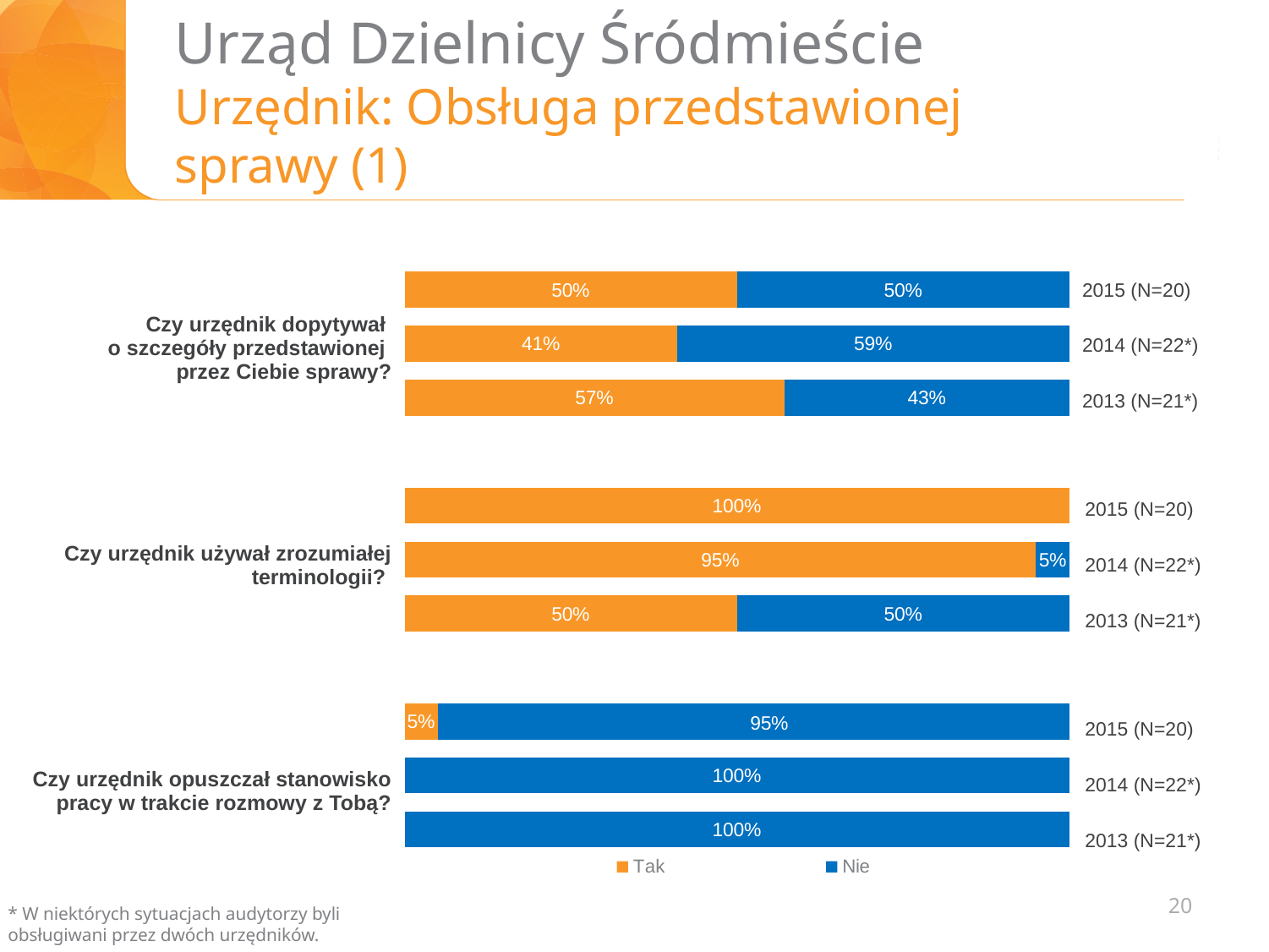
How many series does the legend list? 2 For the question "Czy urzędnik używał zrozumiałej terminologii?", is the "Tak" value for 2014 (N=22*) larger or smaller than the "Tak" value for 2013 (N=21*)? Larger What kind of chart is shown on the slide? Stacked bar chart For the question "Czy urzędnik dopytywał o szczegóły przedstawionej przez Ciebie sprawy?", what is the "Tak" value for 2014 (N=22*)? 41% For the question "Czy urzędnik używał zrozumiałej terminologii?", what is the "Tak" value for 2015 (N=20)? 100% For the question "Czy urzędnik dopytywał o szczegóły przedstawionej przez Ciebie sprawy?", what is the difference between the "Nie" value for 2014 (N=22*) and the "Nie" value for 2013 (N=21*)? 16% For the question "Czy urzędnik dopytywał o szczegóły przedstawionej przez Ciebie sprawy?", what is the "Nie" value for 2013 (N=21*)? 43% For the question "Czy urzędnik dopytywał o szczegóły przedstawionej przez Ciebie sprawy?", which year has the highest "Tak" value? 2013 (N=21*) For the question "Czy urzędnik opuszczał stanowisko pracy w trakcie rozmowy z Tobą?", what is the "Nie" value for 2015 (N=20)? 95% What are the two series named in the legend? Tak and Nie For the question "Czy urzędnik używał zrozumiałej terminologii?", which year has the lowest "Tak" value? 2013 (N=21*) For the question "Czy urzędnik używał zrozumiałej terminologii?", what is the "Nie" value for 2014 (N=22*)? 5%